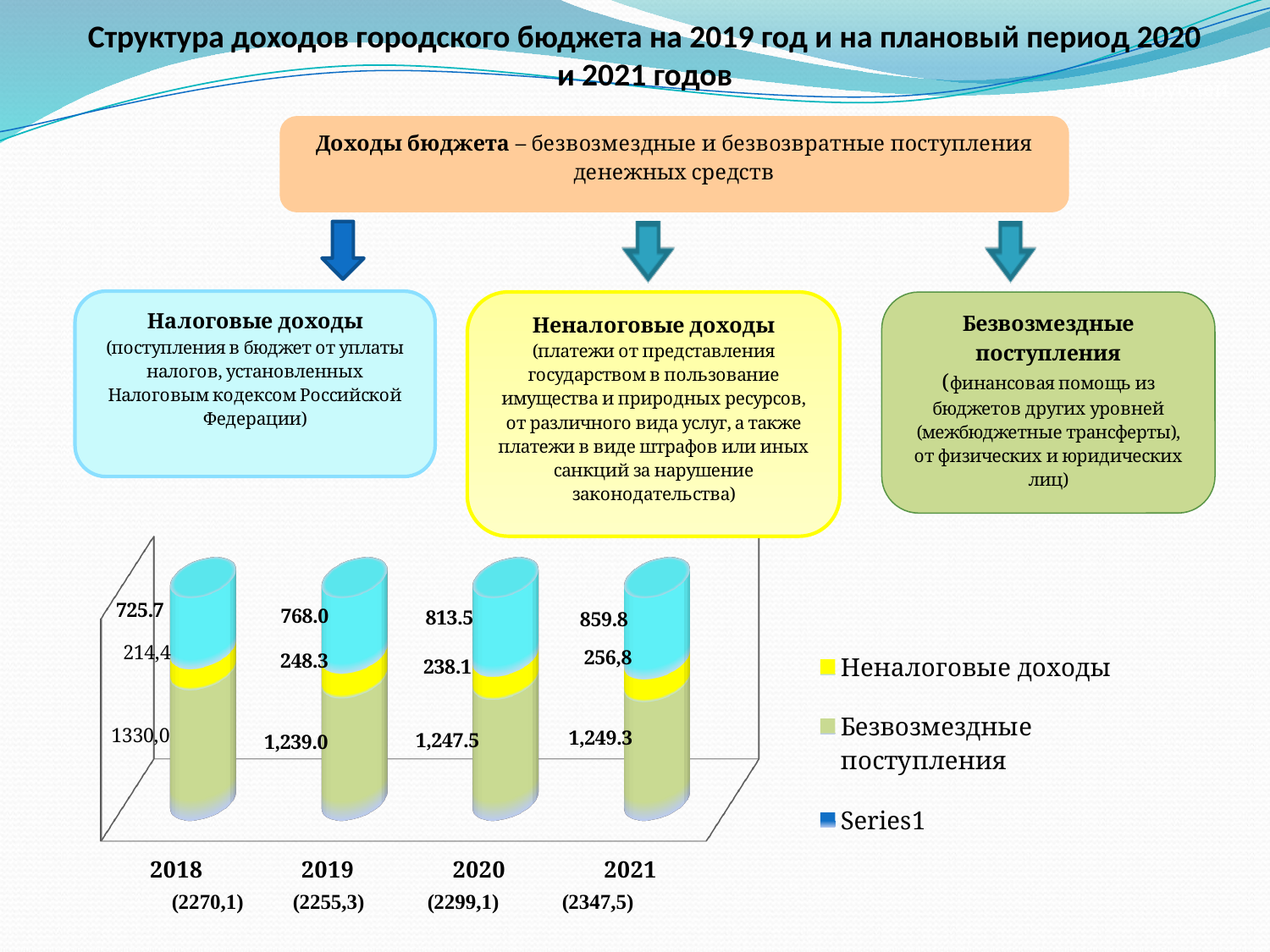
What is the difference between the top (cyan) segment values for 2021 and 2018? 134.1 What total is printed in parentheses under the 2021 bar? (2347,5) How many series does the chart legend list? 3 What is the value of Безвозмездные поступления (green segment) for 2021? 1,249.3 Which year has the larger Безвозмездные поступления (green) value, 2018 or 2019? 2018 What is the value of Неналоговые доходы (yellow segment) for 2019? 248.3 Do the values of the top (cyan) segment rise or fall from 2018 to 2021? Rise In which year is the Неналоговые доходы (yellow) value the lowest? 2018 What value is printed on the top (cyan) segment of the 2020 bar? 813.5 In which year is the Неналоговые доходы (yellow) value the highest? 2021 How many years (categories) are shown on the x axis of the chart? 4 What kind of chart is shown at the bottom of the slide? Stacked bar chart